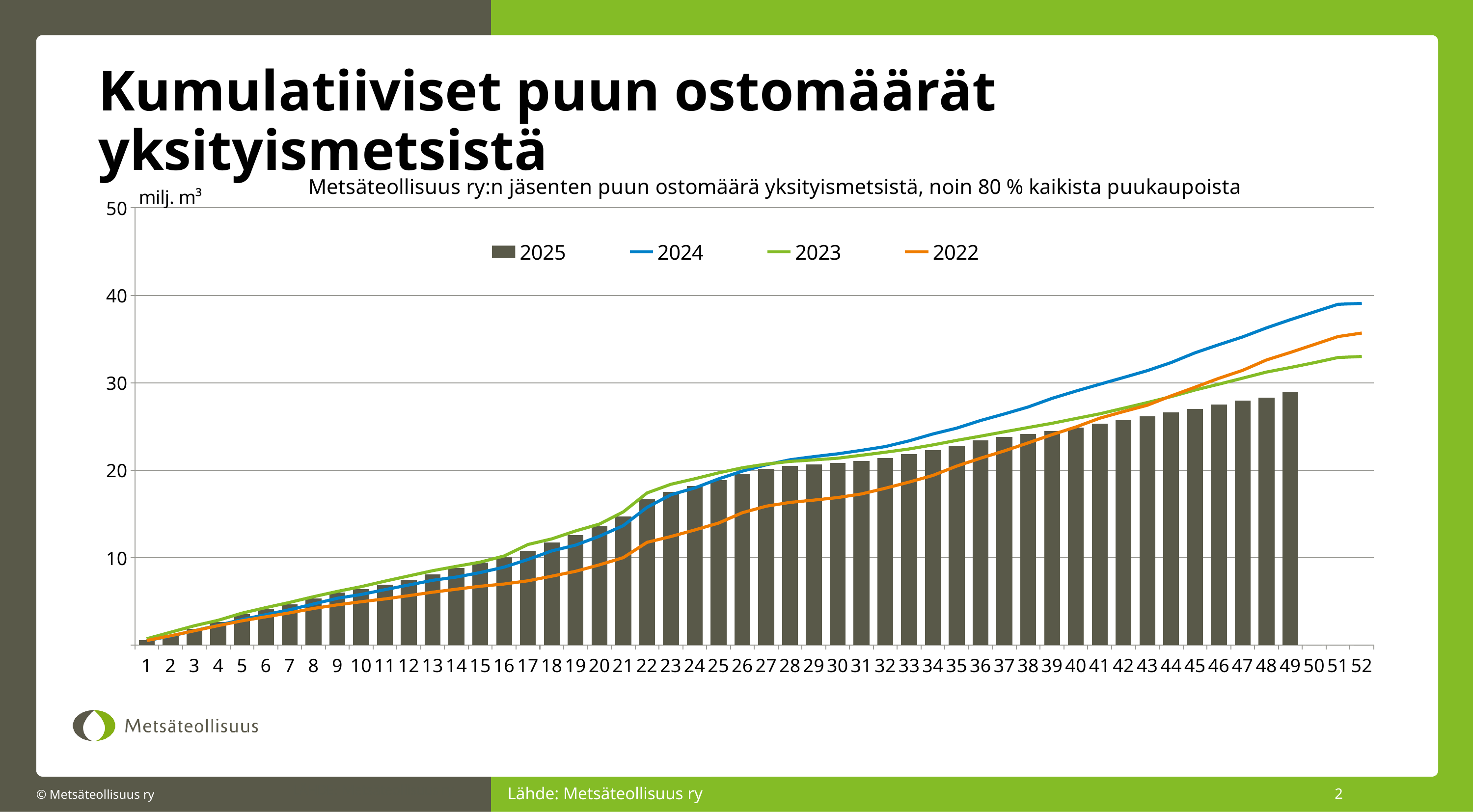
Is the 2022 value at week 20 greater or less than 10? less What kind of chart is this? A combination of a bar chart and line chart Which series has the highest value at week 52? 2024 What unit is shown on the y axis? milj. m³ How many weeks are labelled on the x axis? 52 Is the 2025 bar at week 49 greater or less than 30? less At week 40, which is larger: the 2024 value or the 2022 value? 2024 Which series is plotted as bars? 2025 Is the 2024 value at week 52 greater or less than 40? less How many series does the legend list? 4 Do the cumulative values rise or fall along the x axis? Rise Which series has the lowest value at week 52? 2023